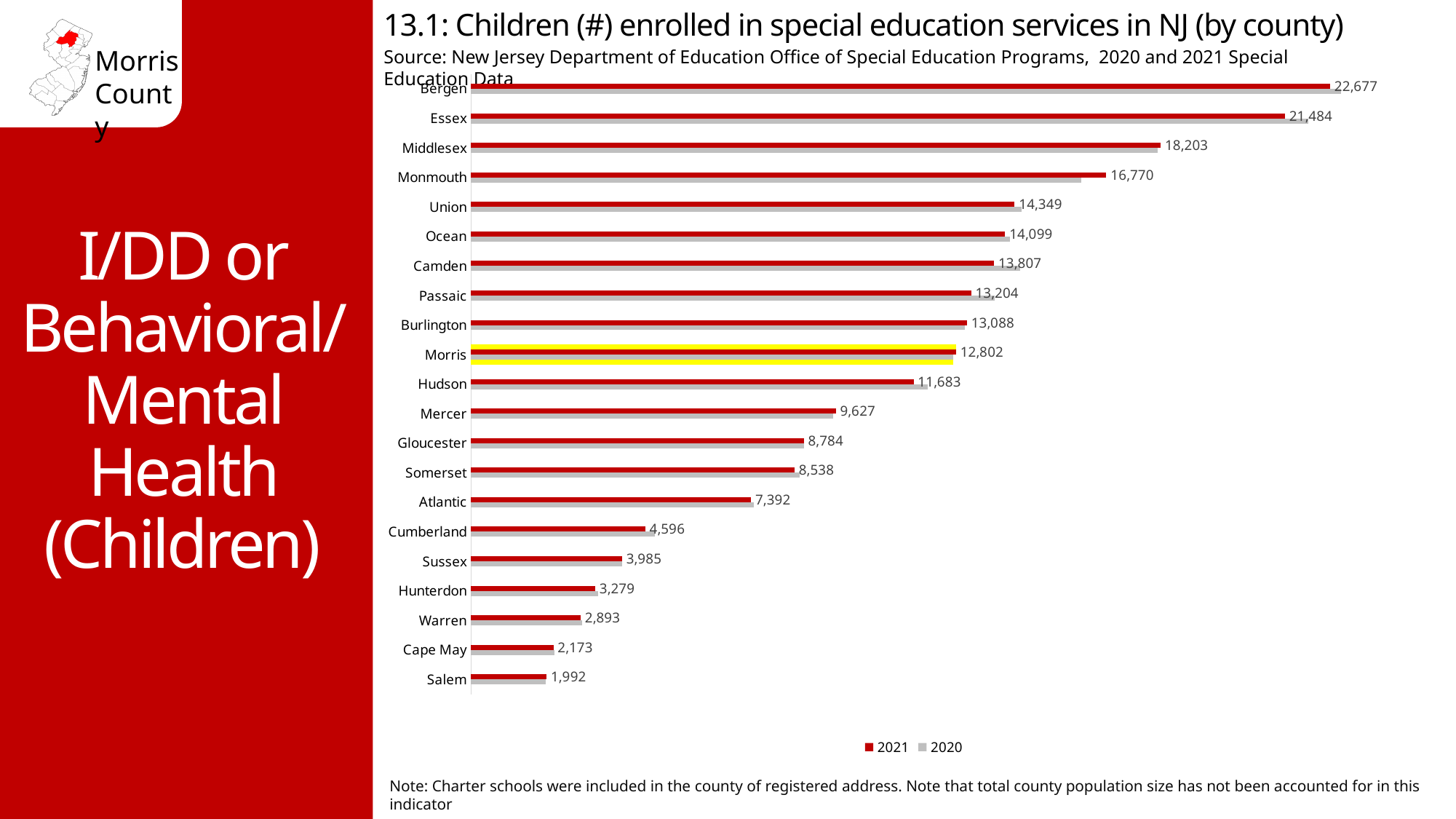
What is the difference between the 2021 values for Bergen and Essex? 1,193 What is the 2021 value for Bergen County? 22,677 How many counties are shown in the chart? 21 How many series does the legend list? 2 What is the 2021 value for Salem County? 1,992 What is the 2021 value for Morris County? 12,802 Which has a larger 2021 value, Mercer or Gloucester? Mercer Which county has the highest 2021 value? Bergen What kind of chart is shown on the slide? Bar chart What is the difference between the 2021 values for Morris and Hudson? 1,119 Which year is represented by the red bars? 2021 Which county has the lowest 2021 value? Salem